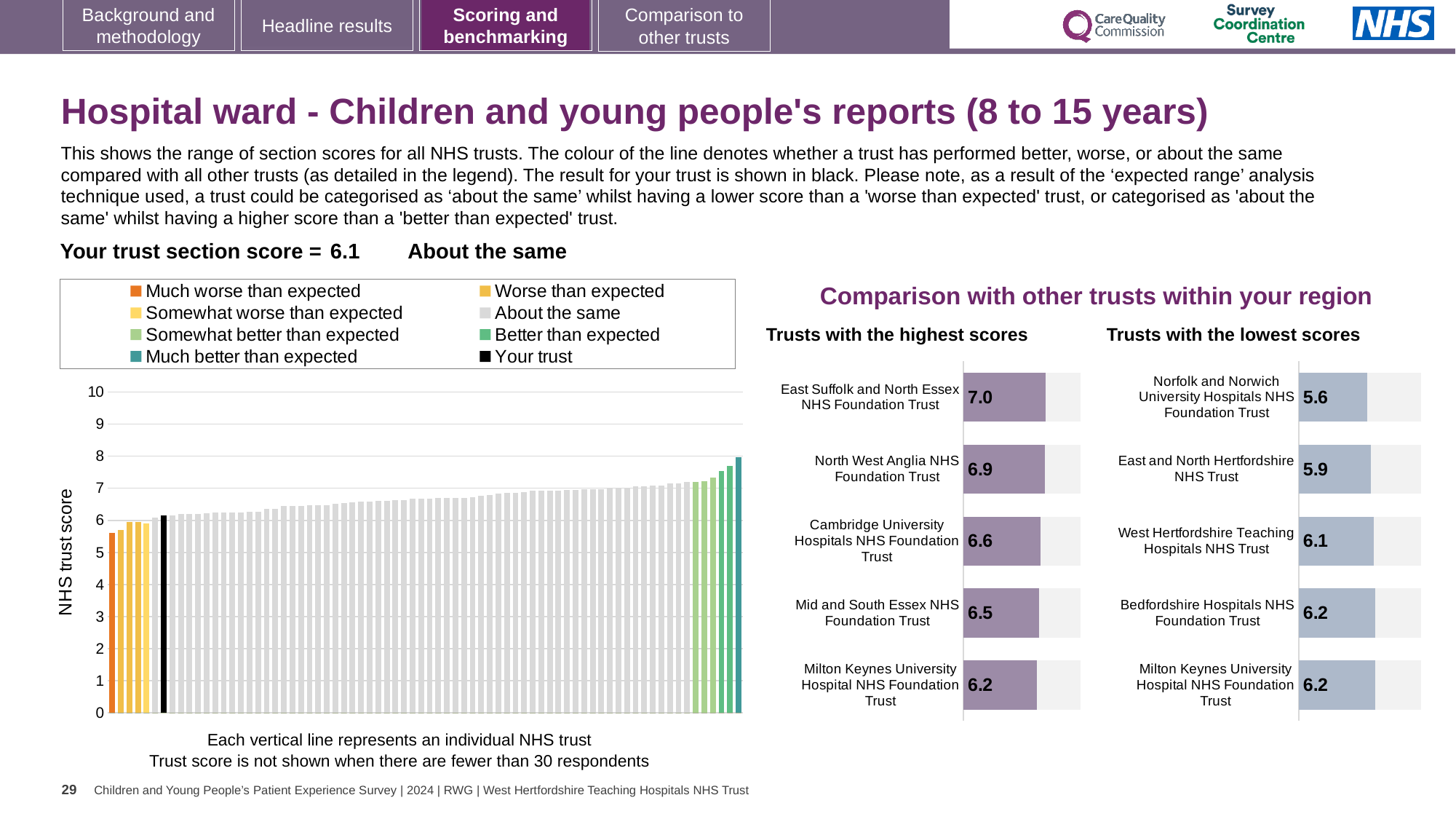
In the 'Trusts with the lowest scores' chart, what is the score for Norfolk and Norwich University Hospitals NHS Foundation Trust? 5.6 In the 'Trusts with the highest scores' chart, which trust has the highest score? East Suffolk and North Essex NHS Foundation Trust In the 'Trusts with the lowest scores' chart, what is the difference between the scores of Bedfordshire Hospitals NHS Foundation Trust and Norfolk and Norwich University Hospitals NHS Foundation Trust? 0.6 How many trusts are shown in the 'Trusts with the highest scores' chart? 5 In the 'Trusts with the highest scores' chart, what is the difference between the scores of East Suffolk and North Essex NHS Foundation Trust and Milton Keynes University Hospital NHS Foundation Trust? 0.8 In the 'Trusts with the lowest scores' chart, which trust has the lowest score? Norfolk and Norwich University Hospitals NHS Foundation Trust In the 'Trusts with the lowest scores' chart, which has the higher score: East and North Hertfordshire NHS Trust or West Hertfordshire Teaching Hospitals NHS Trust? West Hertfordshire Teaching Hospitals NHS Trust In the NHS trust score chart on the left, what is the section score for your trust? 6.1 In the 'Trusts with the highest scores' chart, what is the score for East Suffolk and North Essex NHS Foundation Trust? 7.0 In the NHS trust score chart on the left, do the values rise or fall from left to right? Rise What kind of chart is the NHS trust score chart on the left of the slide? Bar chart How many entries does the legend of the NHS trust score chart on the left list? 8